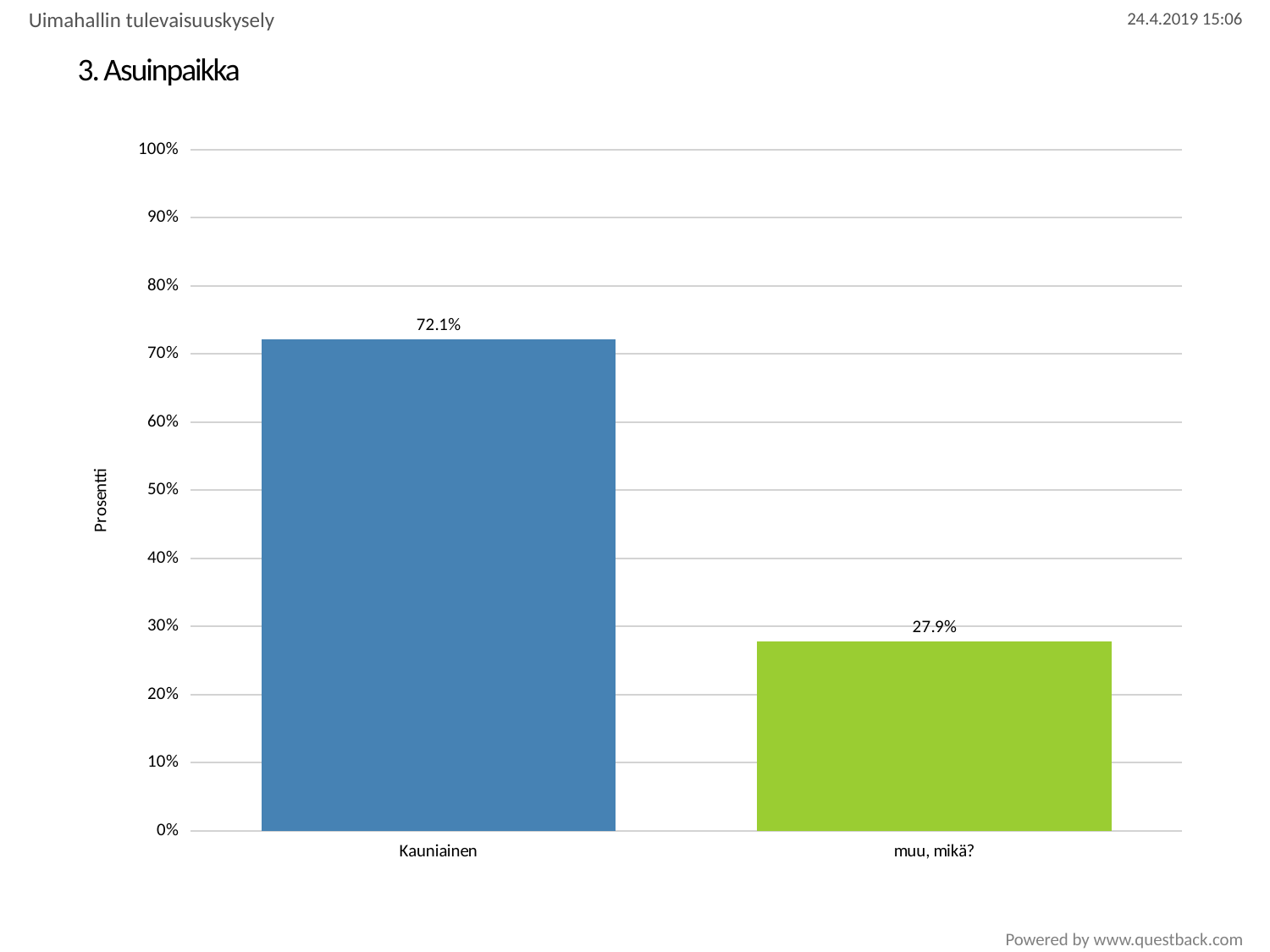
Which is larger, the value for Kauniainen or the value for "muu, mikä?"? Kauniainen What is the value for "muu, mikä?"? 27.9% What is the difference between the values for Kauniainen and "muu, mikä?"? 44.2% What is the label of the y axis? Prosentti Which category has the highest value? Kauniainen What is the value for Kauniainen? 72.1% What is the title of the chart? 3. Asuinpaikka Is the value for Kauniainen greater or less than 70%? greater How many categories are shown on the x axis? 2 Is the value for "muu, mikä?" greater or less than 30%? less Which category has the lowest value? muu, mikä? What kind of chart is shown on the slide? bar chart